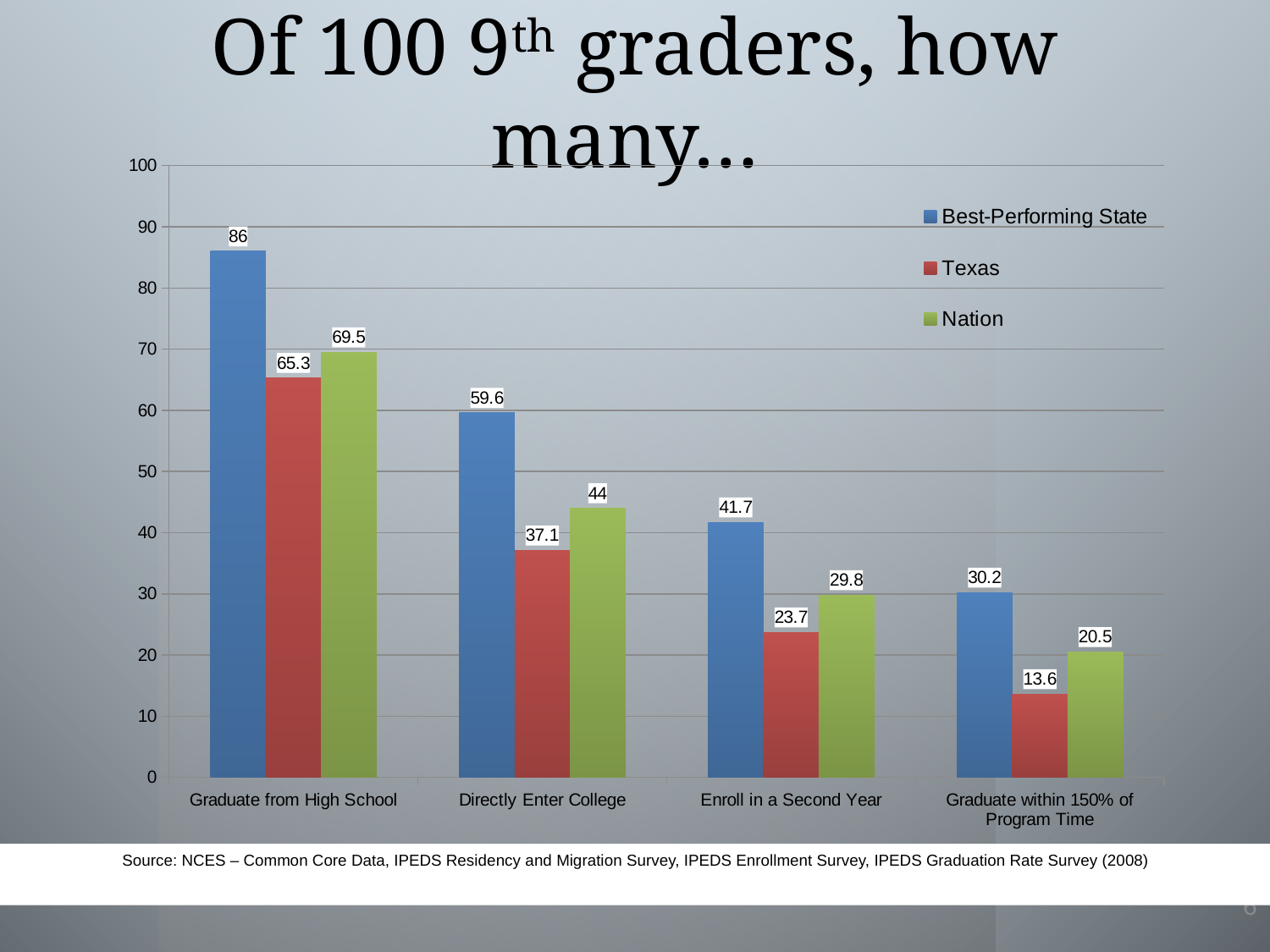
Which category has the lowest value for Nation? Graduate within 150% of Program Time What is the value for Best-Performing State in the Enroll in a Second Year category? 41.7 Which is larger in the Directly Enter College category: the Texas value or the Nation value? Nation What is the value for Nation in the Directly Enter College category? 44 What is the value for Texas in the Graduate from High School category? 65.3 How many series does the legend list? 3 What is the difference between the Best-Performing State and Texas values in the Graduate from High School category? 20.7 What kind of chart is shown on the slide? Bar chart What is the value for Texas in the Graduate within 150% of Program Time category? 13.6 Which category has the highest value for Best-Performing State? Graduate from High School How many categories are shown on the x axis? 4 Do the Texas values rise or fall from left to right across the categories? Fall